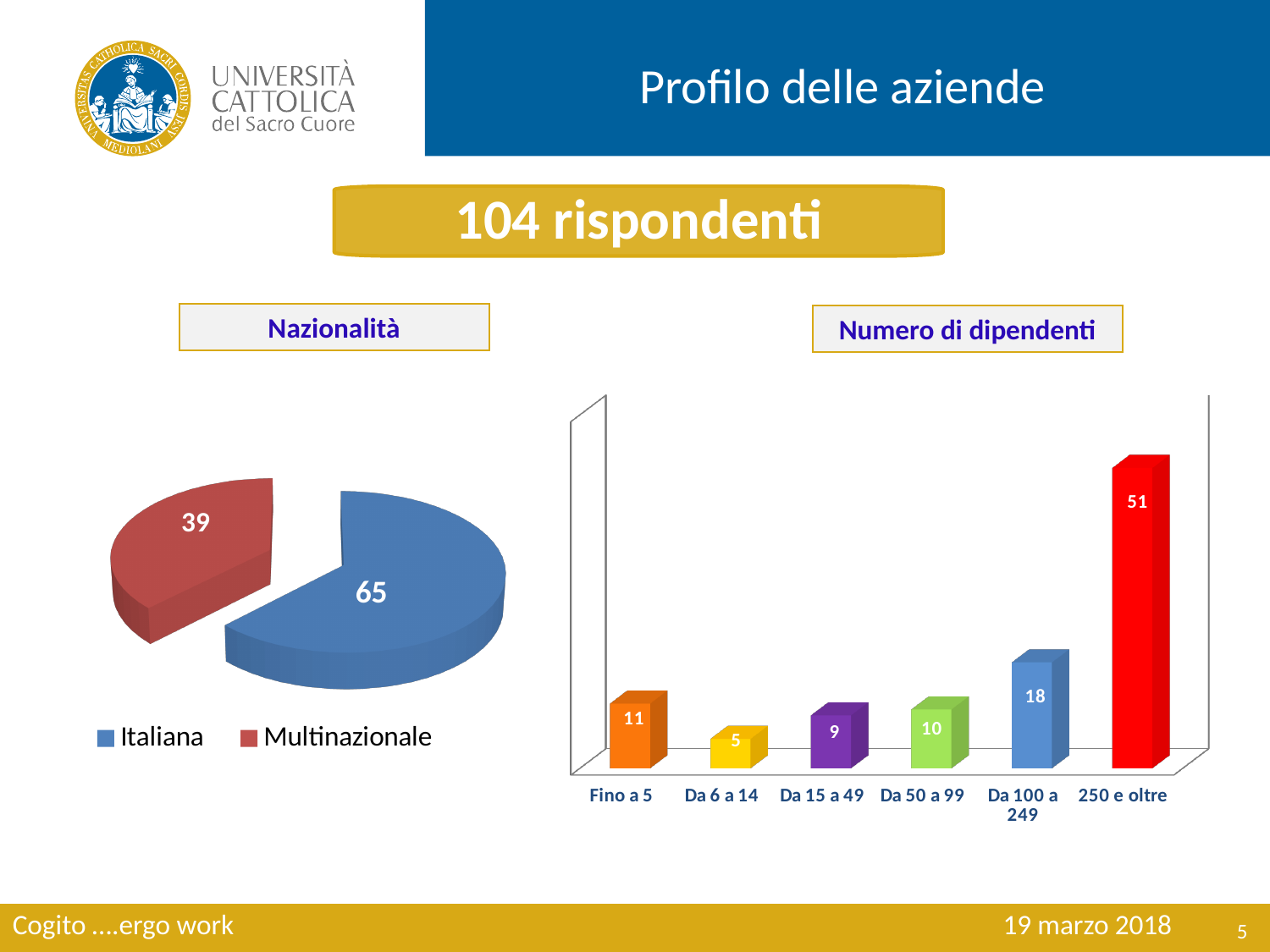
In the Numero di dipendenti chart, what is the value for 250 e oltre? 51 In the Numero di dipendenti chart, what is the difference between the values for 250 e oltre and Da 100 a 249? 33 In the Numero di dipendenti chart, which category has the lowest value? Da 6 a 14 In the Nazionalità pie chart, what is the difference between the Italiana and Multinazionale values? 26 How many categories are shown in the Numero di dipendenti bar chart? 6 In the Numero di dipendenti chart, which category has the highest value? 250 e oltre In the Nazionalità pie chart, what is the value for Italiana? 65 What kind of chart is the Nazionalità chart? Pie chart In the Numero di dipendenti chart, which is larger, the value for Fino a 5 or the value for Da 50 a 99? Fino a 5 In the Nazionalità pie chart, what is the value for Multinazionale? 39 How many entries does the legend of the Nazionalità pie chart list? 2 In the Numero di dipendenti chart, what is the value for Da 6 a 14? 5